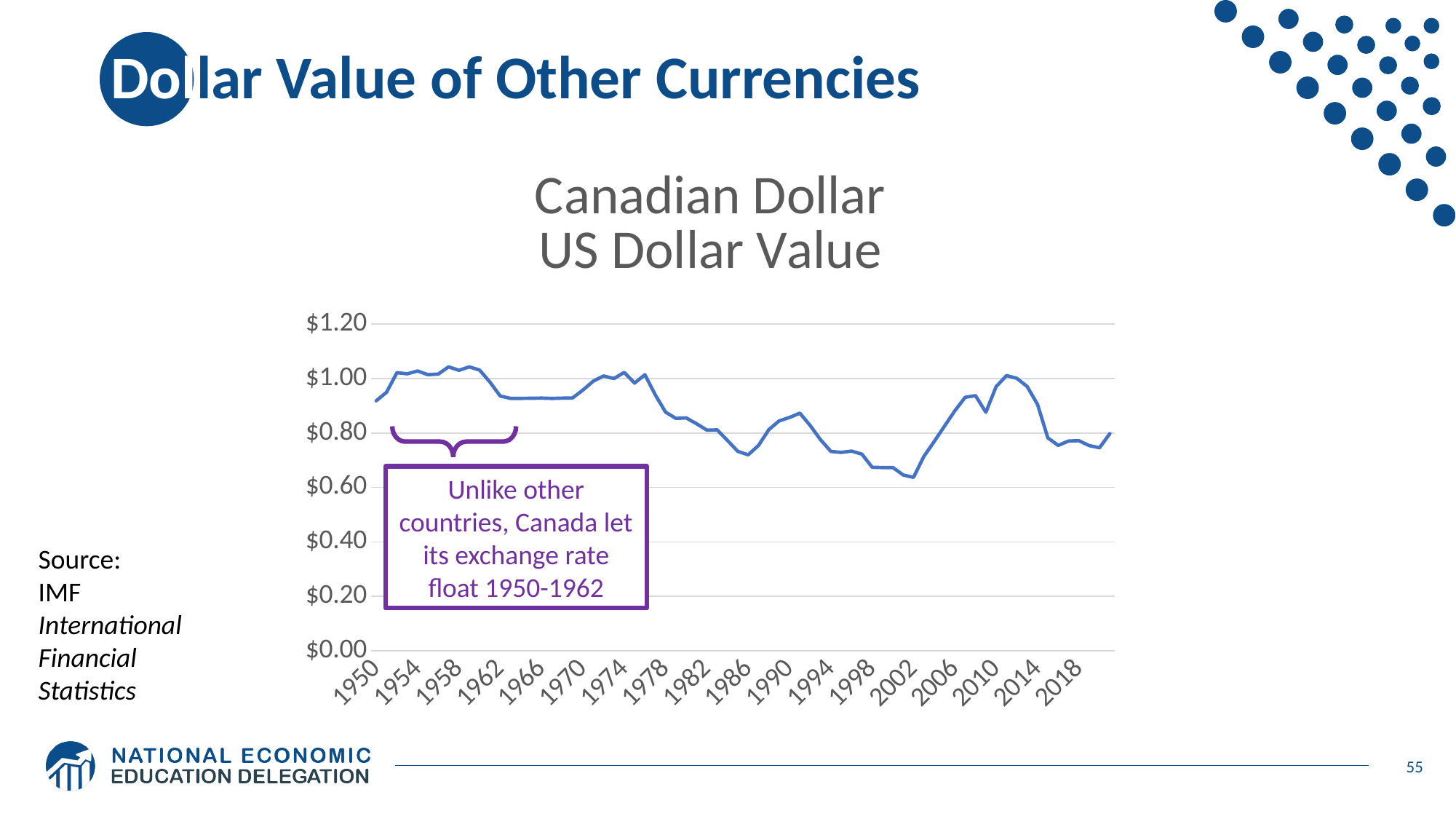
Is the value for 1974 greater or less than $0.80? greater What is the title of the chart? Canadian Dollar US Dollar Value Is the value for 2010 greater or less than $0.80? greater What kind of chart is shown on the slide? line chart Does the value rise or fall between 1978 and 1986? fall Is the value for 2002 greater or less than $0.80? less Does the value rise or fall between 2002 and 2010? rise Which is larger, the value for 1974 or the value for 2002? 1974 According to the annotation on the chart, during which years did Canada let its exchange rate float? 1950-1962 Of the years labelled on the x axis, in which year is the value lowest? 2002